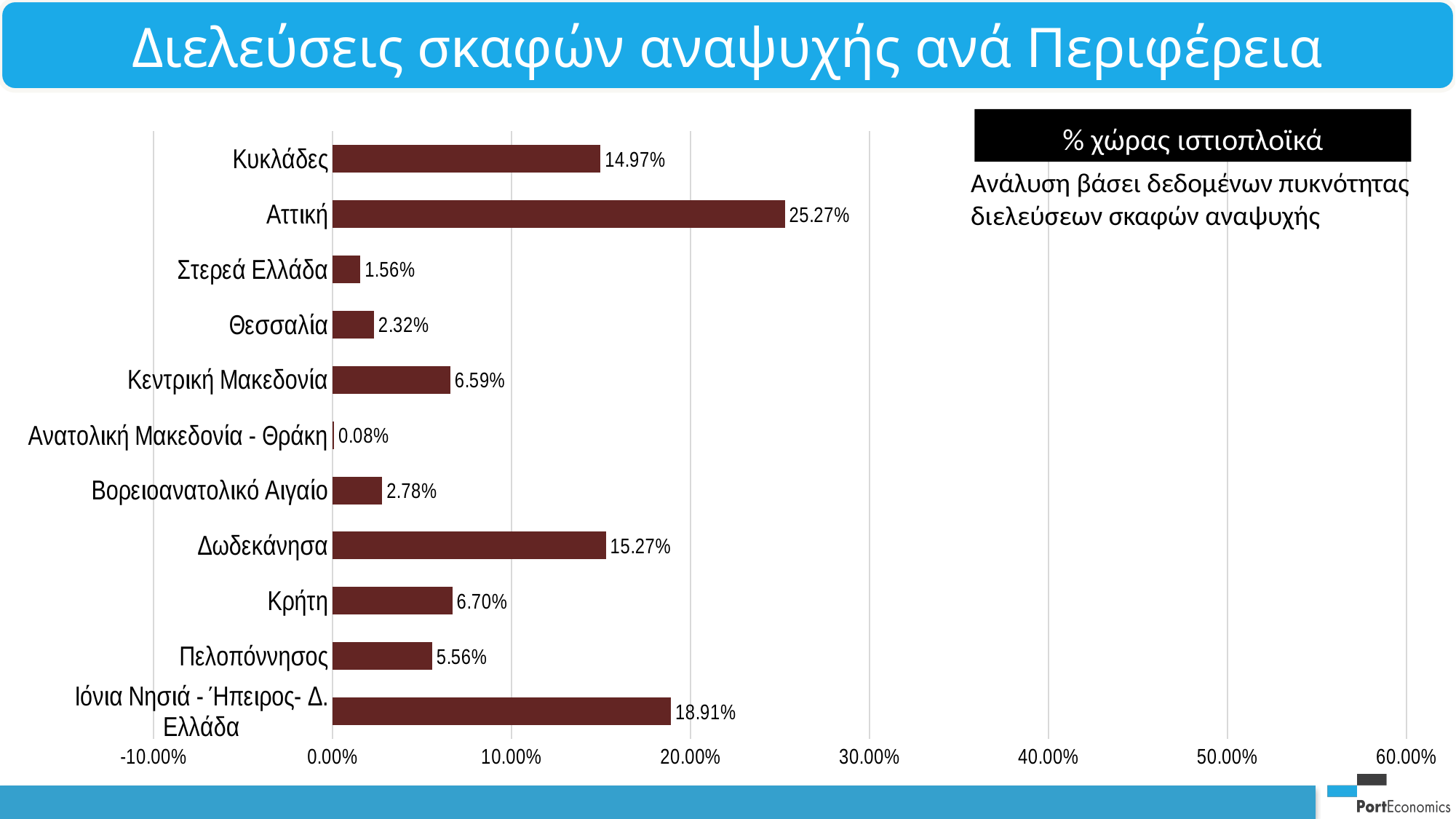
Which region has the lowest value? Ανατολική Μακεδονία - Θράκη What is the difference between the values for Αττική and Ιόνια Νησιά - Ήπειρος- Δ. Ελλάδα? 6.36% How many regions are shown in the chart? 11 Is the value for Ιόνια Νησιά - Ήπειρος- Δ. Ελλάδα greater or less than 20.00%? less Which region has the highest value? Αττική What is the value for Ανατολική Μακεδονία - Θράκη? 0.08% What is the title of the chart? Διελεύσεις σκαφών αναψυχής ανά Περιφέρεια What kind of chart is shown on the slide? bar chart What is the value for Δωδεκάνησα? 15.27% What is the value for Πελοπόννησος? 5.56% What is the value for Αττική? 25.27% Which is larger, the value for Κυκλάδες or the value for Κεντρική Μακεδονία? Κυκλάδες